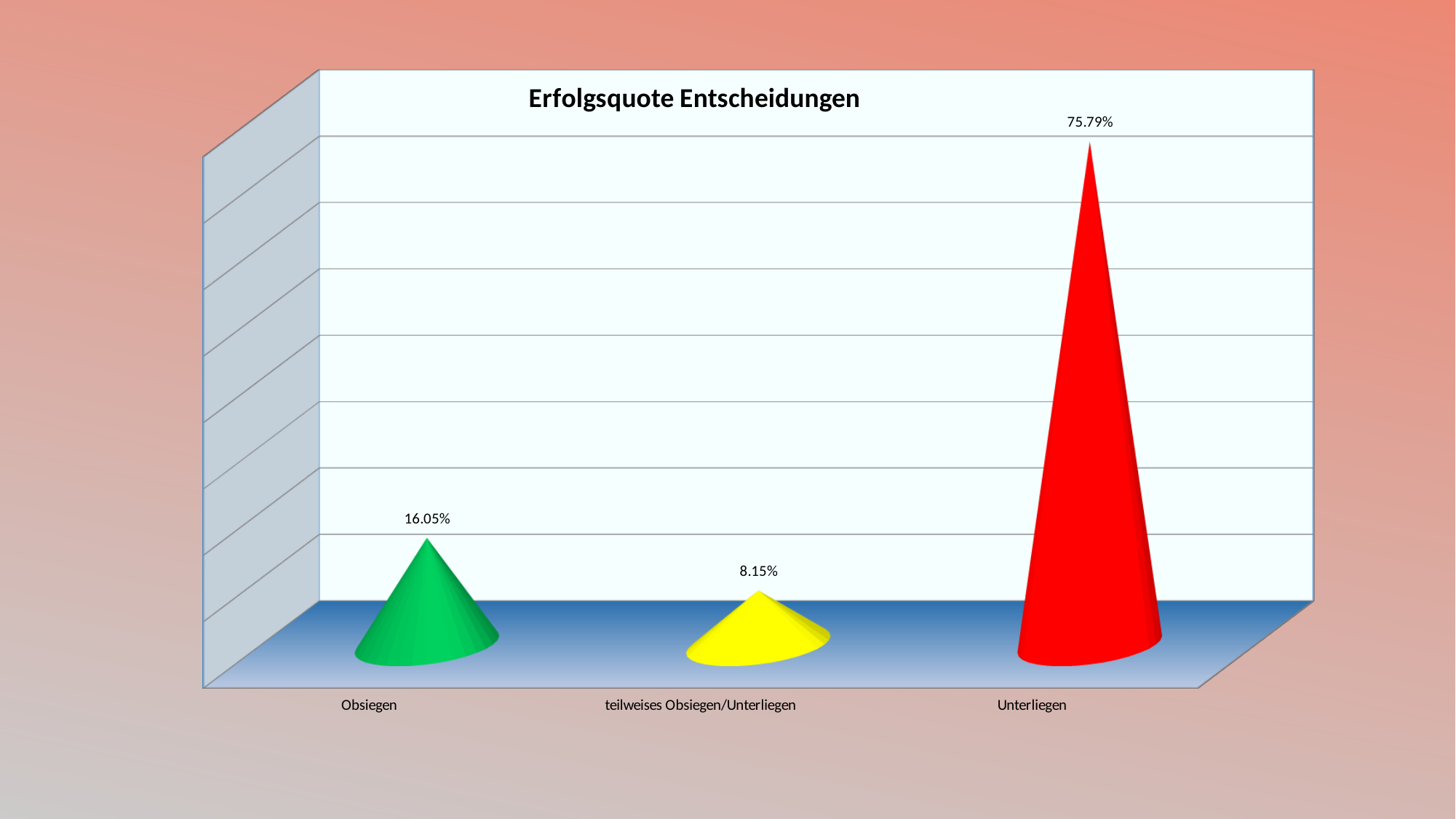
What is the difference between the values for Unterliegen and Obsiegen? 59.74% What is the value for Unterliegen? 75.79% Which is larger, the value for Obsiegen or the value for teilweises Obsiegen/Unterliegen? Obsiegen What is the value for Obsiegen? 16.05% Which category has the highest value? Unterliegen What kind of chart is this? bar chart What is the title of the chart? Erfolgsquote Entscheidungen How many categories are shown in the chart? 3 What is the value for teilweises Obsiegen/Unterliegen? 8.15% Which category has the lowest value? teilweises Obsiegen/Unterliegen What is the difference between the values for Obsiegen and teilweises Obsiegen/Unterliegen? 7.90% What colour is the bar for Unterliegen? red